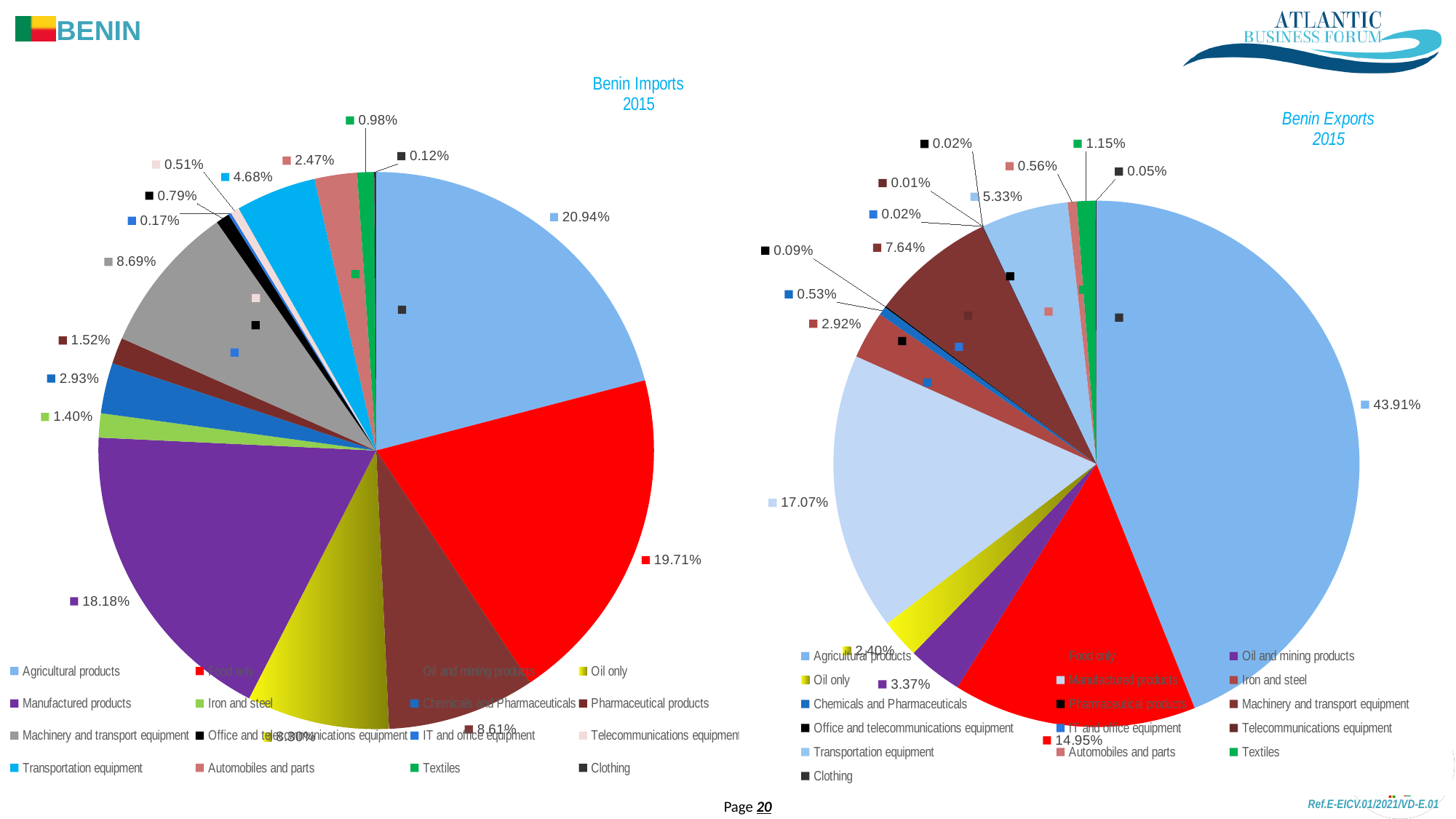
In the Benin Exports 2015 chart, what is the value for Manufactured products? 17.07% In the Benin Imports 2015 chart, what is the difference between Agricultural products and Food only? 1.23% What kind of chart is the Benin Imports 2015 chart? pie chart In the Benin Exports 2015 chart, what is the difference between Agricultural products and Food only? 28.96% In the Benin Exports 2015 chart, what is the value for Machinery and transport equipment? 7.64% In the Benin Imports 2015 chart, what share do Agricultural products have? 20.94% In the Benin Imports 2015 chart, what is the value for Manufactured products? 18.18% In the Benin Imports 2015 chart, which category has the largest share? Agricultural products How many categories does the legend of the Benin Exports 2015 chart list? 16 In the Benin Exports 2015 chart, what share do Agricultural products have? 43.91% In the Benin Imports 2015 chart, what is the value for Transportation equipment? 4.68% In the Benin Exports 2015 chart, which is larger, Food only or Manufactured products? Manufactured products